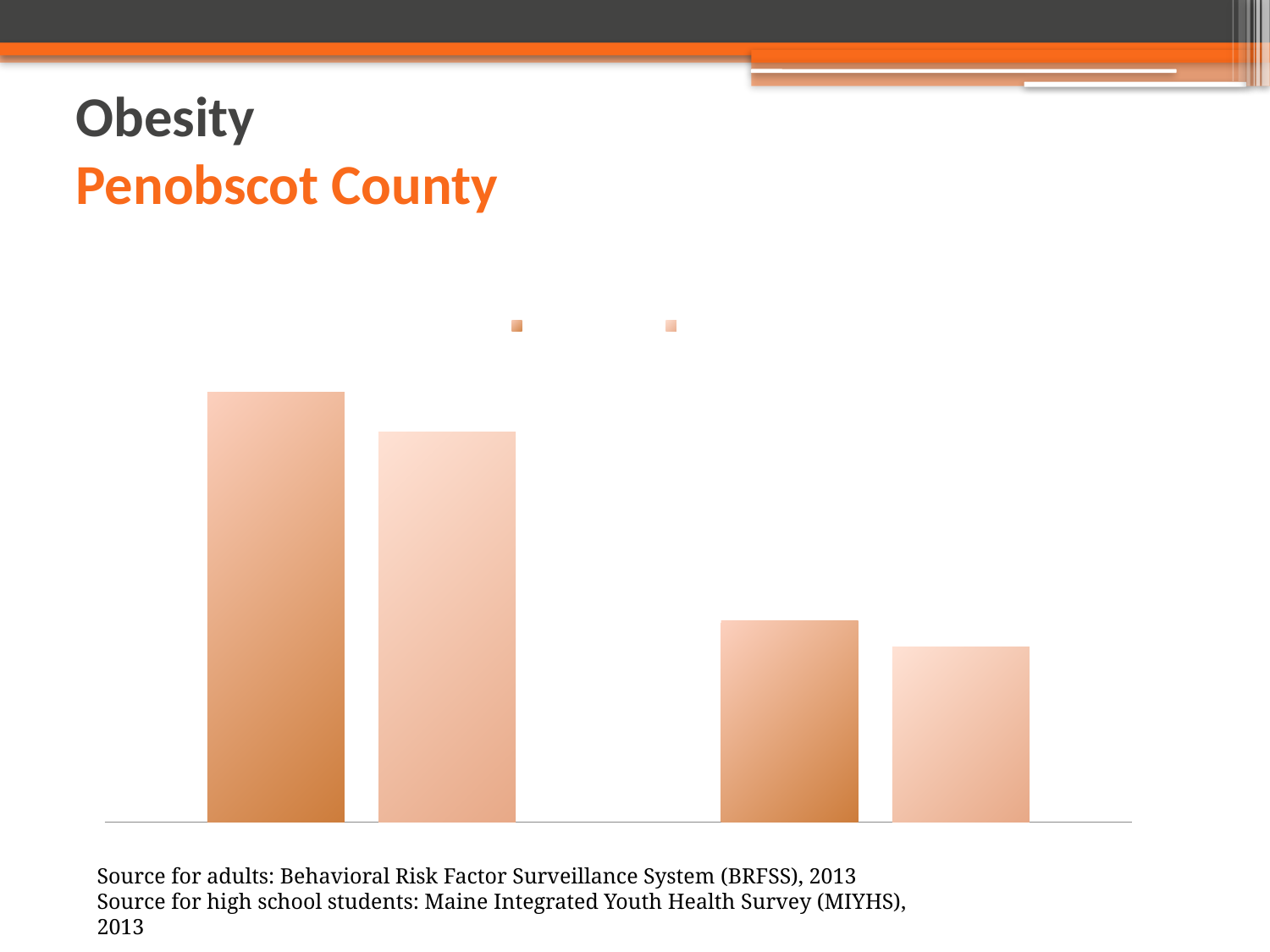
What is the slide's title above the chart? Obesity Penobscot County Which is taller, the leftmost bar or the rightmost bar? the leftmost bar How many series does the chart's legend list? 2 What kind of chart is shown on the slide? bar chart Which bar is the shortest in the chart? the rightmost bar How many bars are plotted in the chart? 4 Into how many groups are the bars arranged in the chart? 2 Which bar is the tallest in the chart? the leftmost bar Which is taller, the second bar from the left or the third bar from the left? the second bar from the left Do the bar heights rise or fall from left to right across the chart? fall